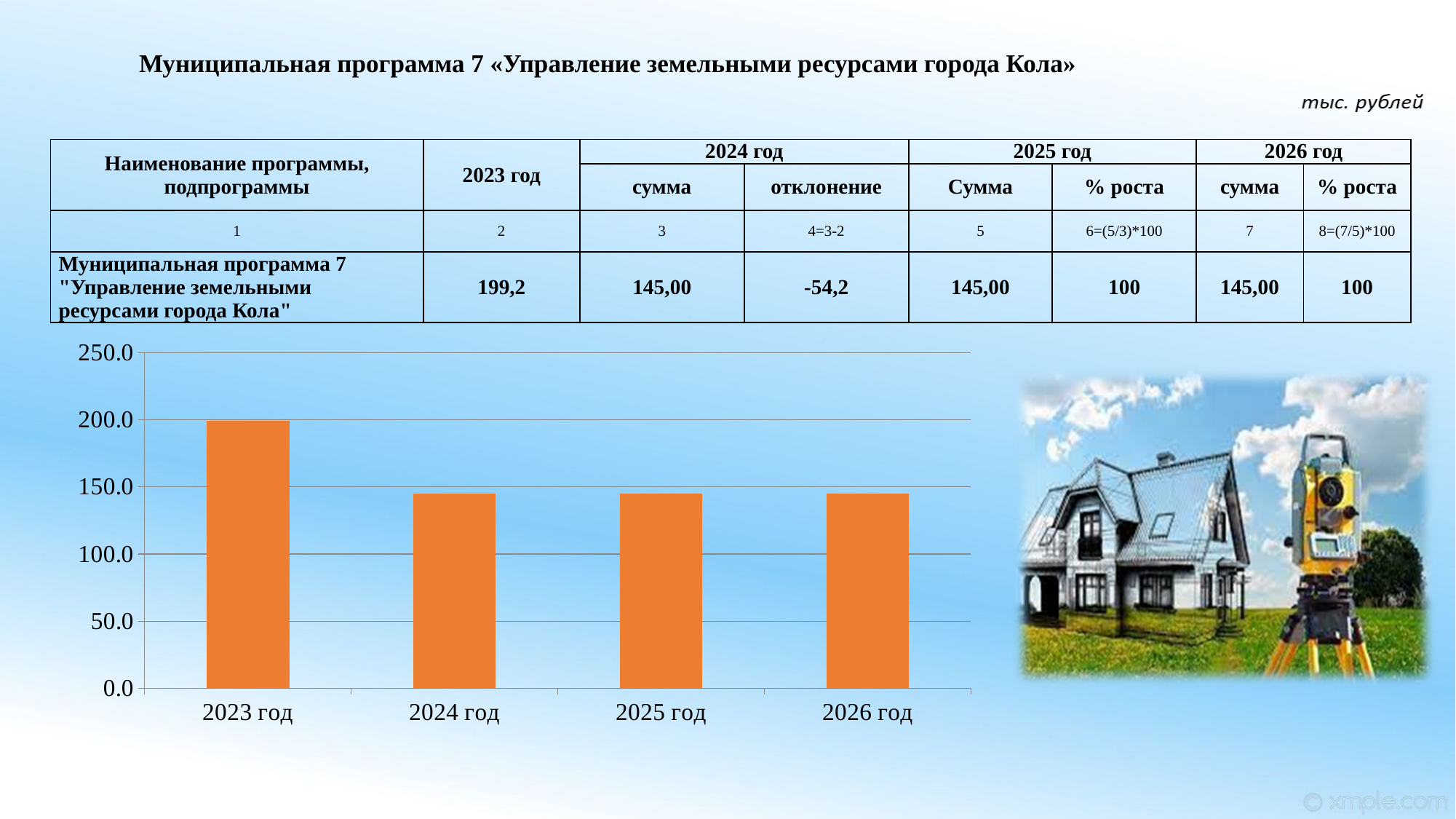
How many bars (years) does the chart show? 4 What is the highest tick value shown on the chart's vertical axis? 250.0 What kind of chart is shown on the slide? bar chart Do the values rise or fall from 2023 год to 2024 год? fall Which year has the highest bar in the chart? 2023 год Is the value for 2026 год greater or less than 200? less Is the value for 2025 год greater or less than 100? greater Is the value for 2024 год greater or less than 150? less What colour are the bars in the chart? orange Which is larger, the value for 2023 год or the value for 2024 год? 2023 год